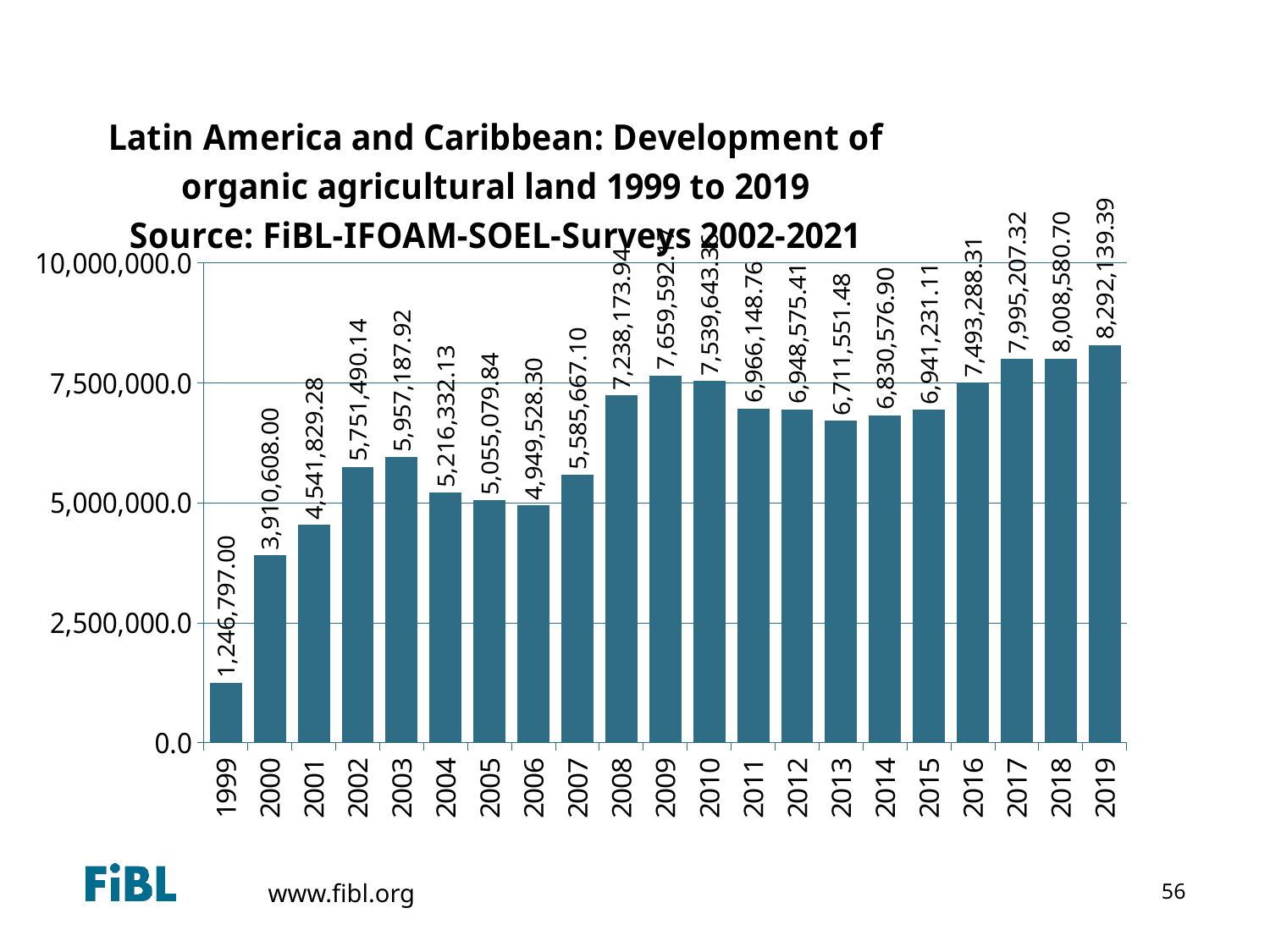
What kind of chart is this? bar chart What is the value for 2006? 4,949,528.30 Is the value for 2001 greater or less than 5,000,000.0? less What is the value for 1999? 1,246,797.00 What is the difference between the values for 2003 and 2002? 205,697.78 Which year has the highest value? 2019 What is the difference between the values for 2019 and 1999? 7,045,342.39 Which is larger, the value for 2008 or the value for 2016? 2016 What is the value for 2013? 6,711,551.48 How many years are shown on the x axis? 21 Which year has the lowest value? 1999 What is the value for 2019? 8,292,139.39